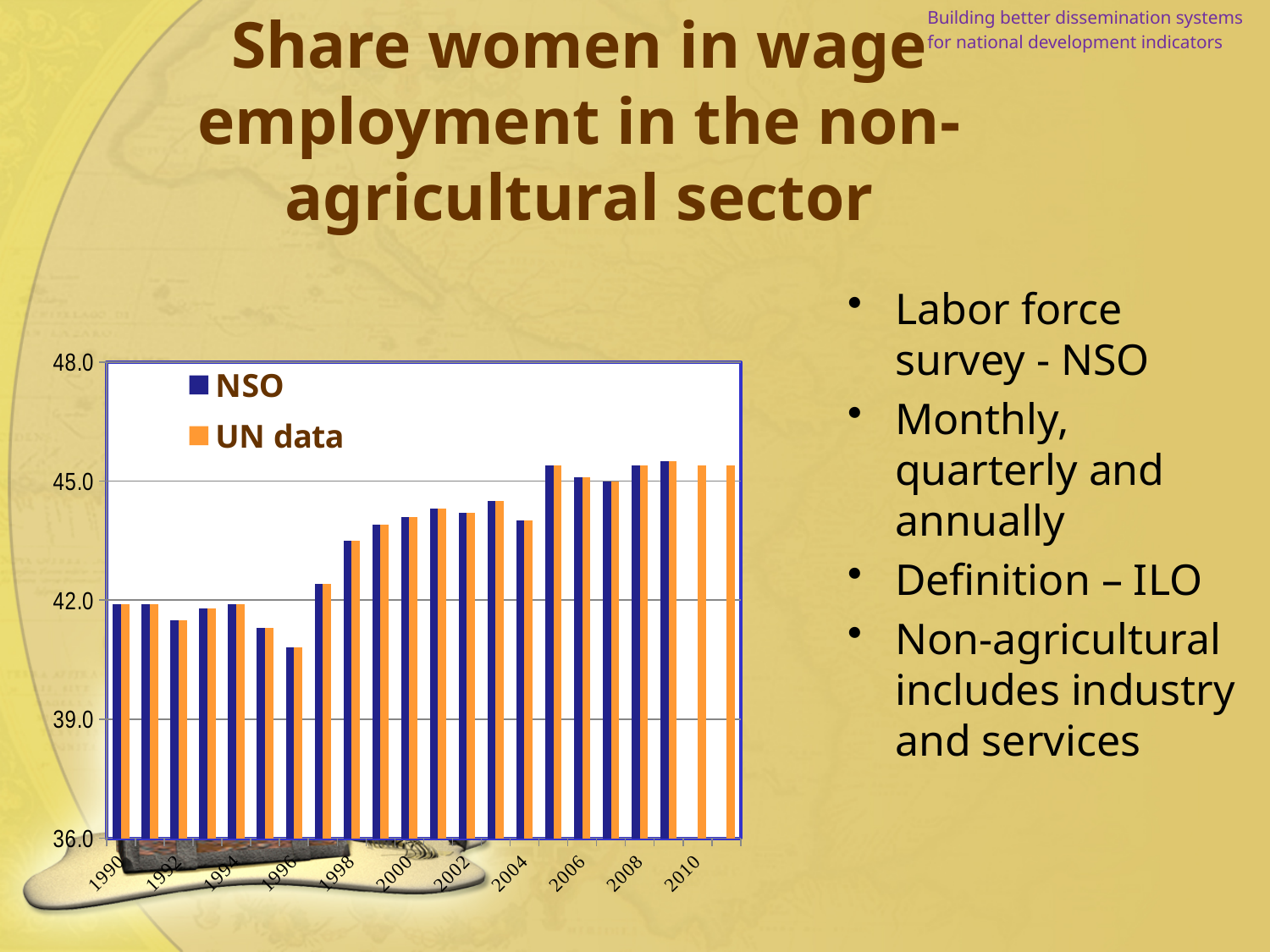
Which year has the higher NSO value, 1996 or 2006? 2006 Which year has the lowest share of women in wage employment in the chart? 1996 What kind of chart is shown on the slide? bar chart Is the NSO value for 1996 greater or less than 42.0? less Overall, do the values rise or fall from 1990 to 2010? rise What are the two series named in the chart legend? NSO and UN data Which colour represents the UN data series in the chart? orange Is the NSO value for 1998 greater or less than 42.0? greater Which year has the higher UN data value, 1998 or 2004? 2004 Is the NSO value for 2004 greater or less than 45.0? less How many series does the chart legend list? 2